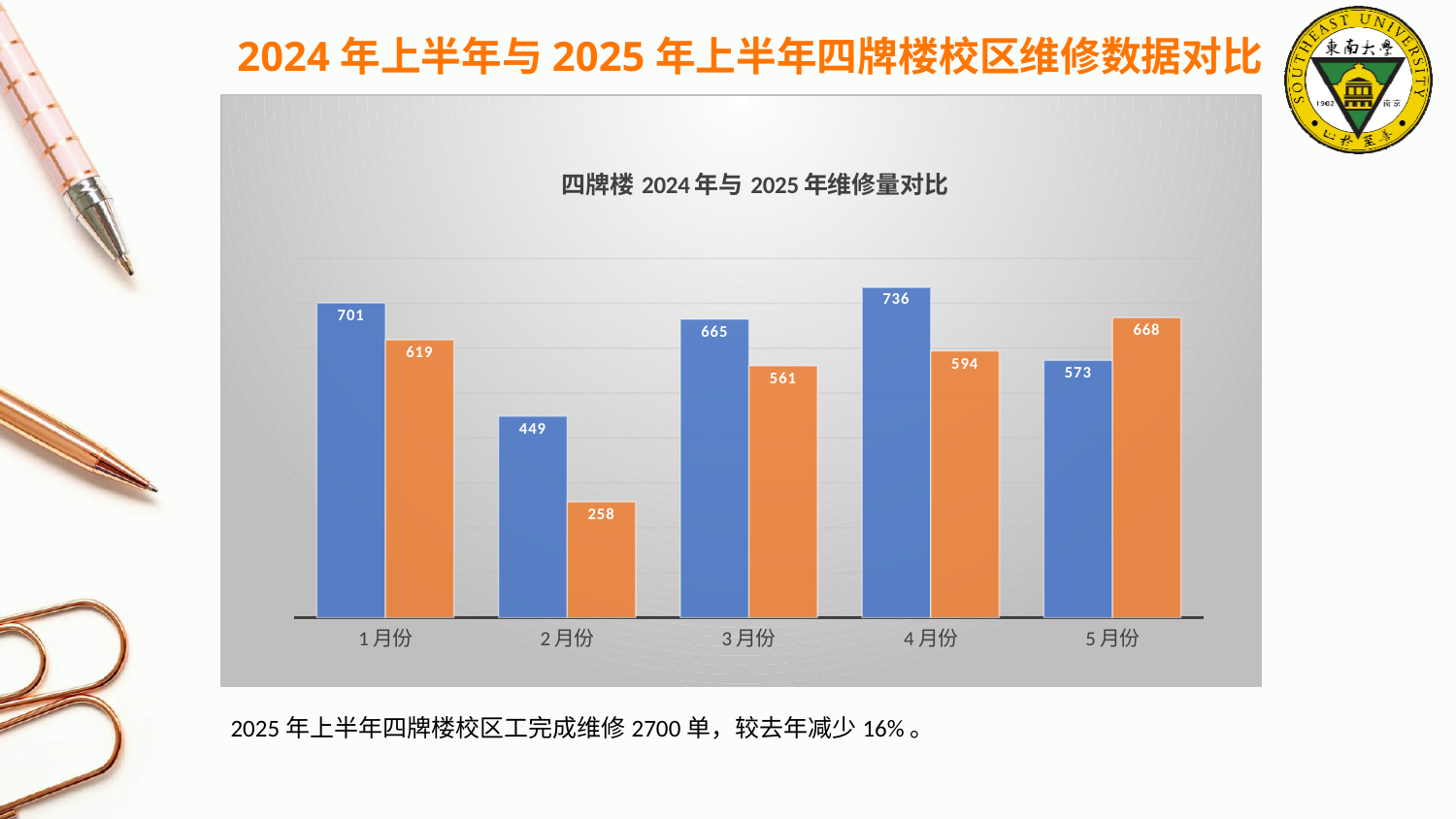
What is the value of the blue bar for 1月份? 701 What is the value of the orange bar for 2月份? 258 What kind of chart is shown on the slide? bar chart How many months are shown on the x axis? 5 For 5月份, which bar is larger, the blue one or the orange one? orange Which month has the lowest orange bar? 2月份 Which month has the highest orange bar? 5月份 What is the difference between the blue bar and the orange bar for 1月份? 82 Which month has the highest blue bar? 4月份 What is the difference between the blue bar and the orange bar for 4月份? 142 What is the title of the chart? 四牌楼 2024年与 2025年维修量对比 What is the value of the orange bar for 4月份? 594